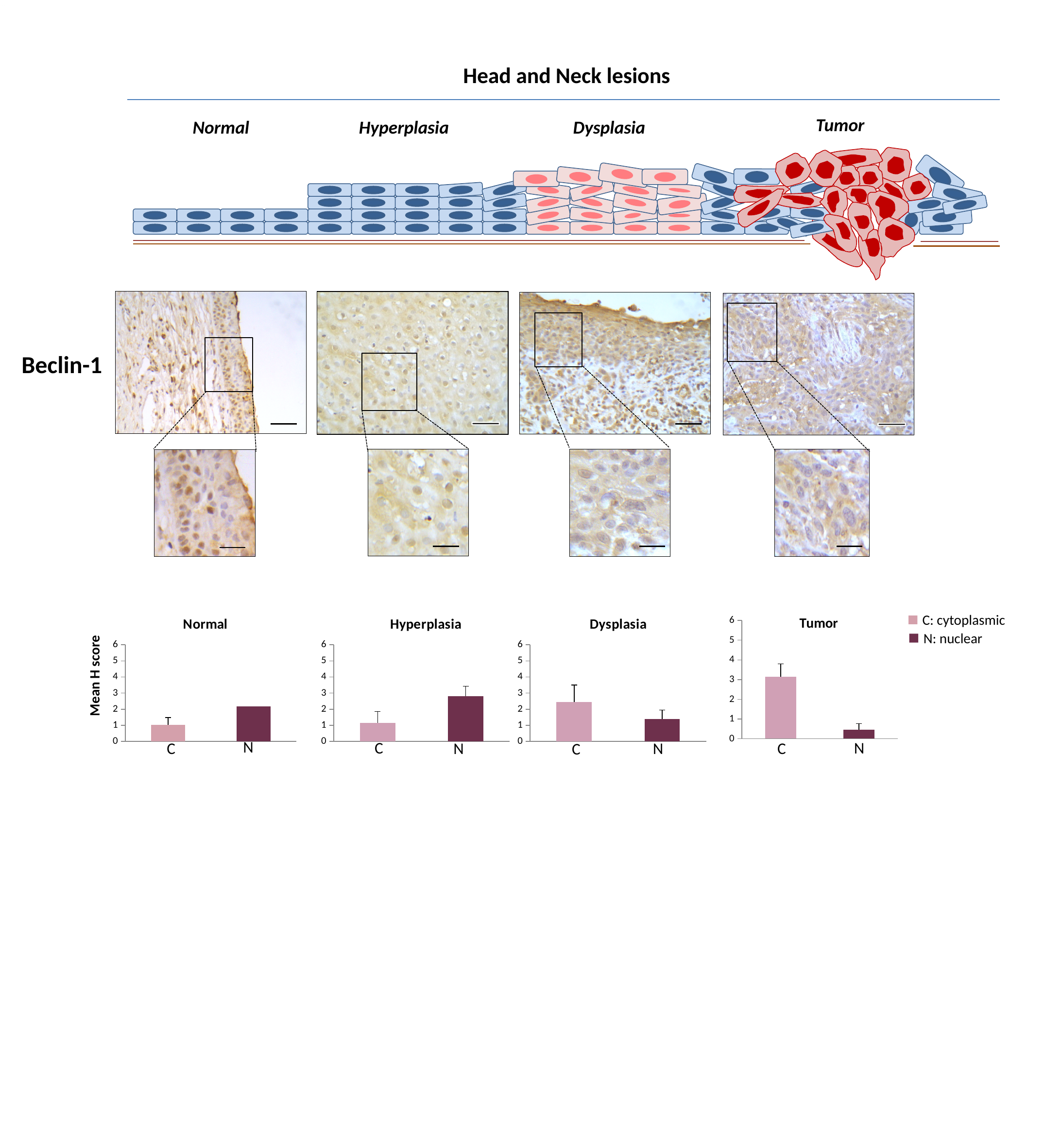
According to the legend, what does N stand for? nuclear In the "Normal" chart, is the value for C greater or less than 2? less How many bars does the "Tumor" chart show? 2 What is the y-axis label of the "Normal" chart? Mean H score In the "Tumor" chart, is the value for N greater or less than 1? less What kind of chart is the "Normal" chart? bar chart In the "Normal" chart, which bar is higher, C or N? N In the "Hyperplasia" chart, is the value for N greater or less than 2? greater In the "Dysplasia" chart, which bar is higher, C or N? C In the "Tumor" chart, which bar is the lowest? N In the "Hyperplasia" chart, which bar is higher, C or N? N